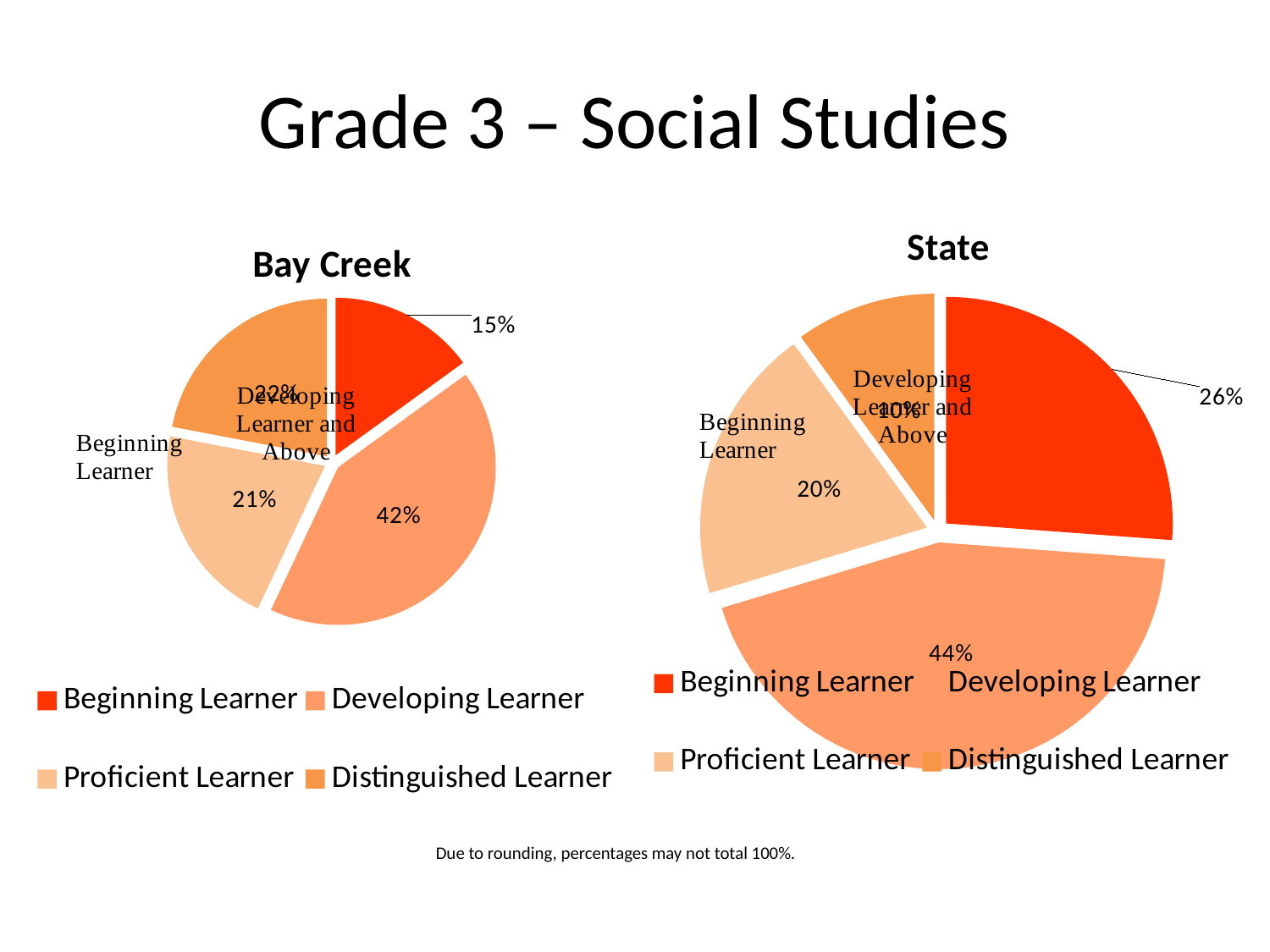
In the State chart, what percentage is shown for Beginning Learner? 26% In the State chart, what percentage is shown for Developing Learner? 44% What is the difference between the Developing Learner percentage in the State chart and in the Bay Creek chart? 2% How many categories does the legend of the Bay Creek chart list? 4 In the Bay Creek chart, which category has the smallest slice? Beginning Learner In the State chart, what percentage is shown for Proficient Learner? 20% In the Bay Creek chart, what percentage is shown for Developing Learner? 42% In the Bay Creek chart, which category has the largest slice? Developing Learner What kind of chart is the Bay Creek chart? pie chart In the Bay Creek chart, what percentage is shown for Beginning Learner? 15% In the Bay Creek chart, what percentage is shown for Proficient Learner? 21% In the State chart, which category has the largest slice? Developing Learner